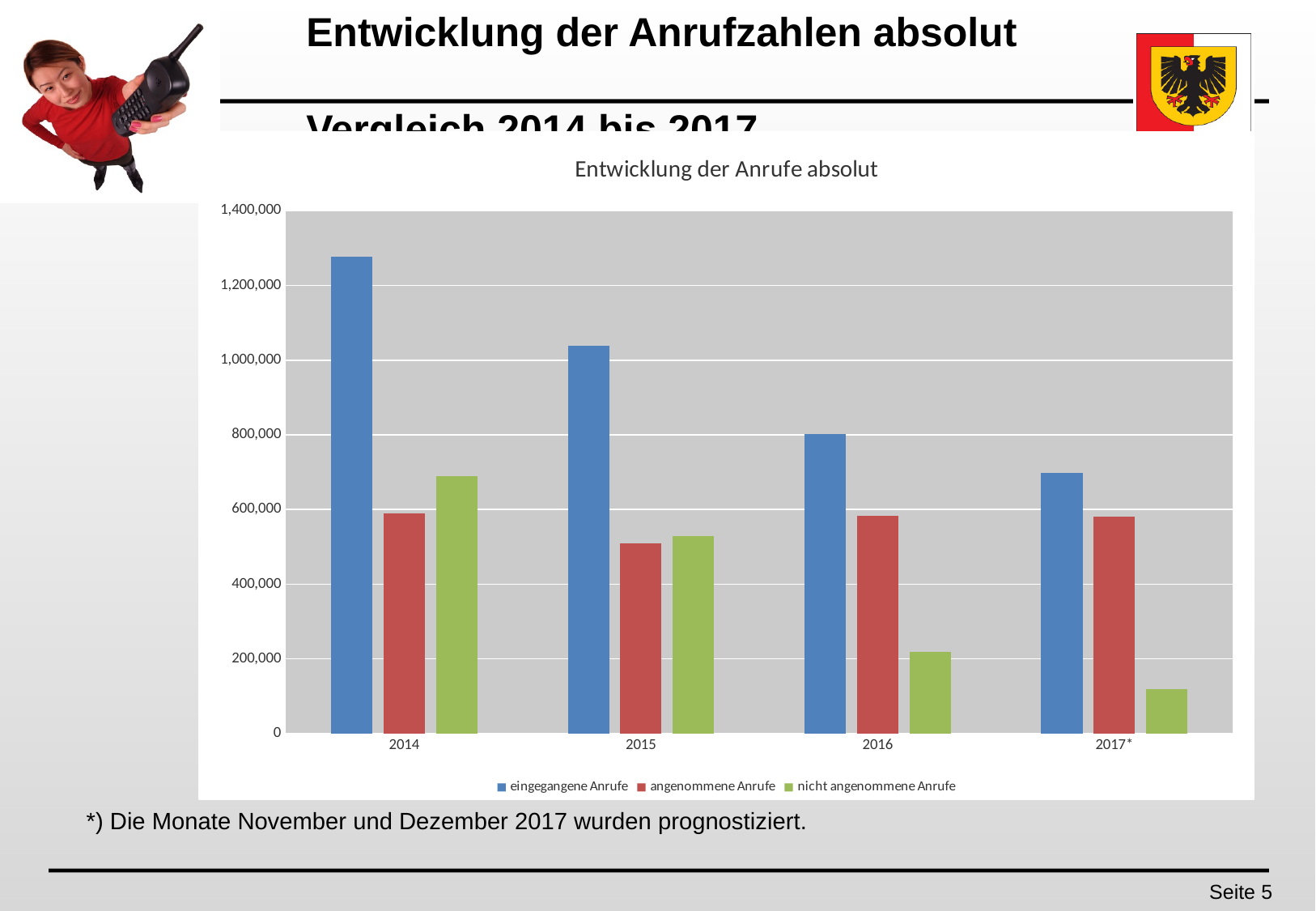
Is the value for angenommene Anrufe in 2015 greater or less than 600,000? less In which year is the value for nicht angenommene Anrufe lowest? 2017* How many series does the legend list? 3 How many years are shown on the x axis? 4 In 2014, which is larger: angenommene Anrufe or nicht angenommene Anrufe? nicht angenommene Anrufe What is the title of the chart? Entwicklung der Anrufe absolut In 2017*, which is larger: angenommene Anrufe or nicht angenommene Anrufe? angenommene Anrufe In which year is the value for eingegangene Anrufe highest? 2014 What kind of chart is shown on the slide? bar chart Do the values for eingegangene Anrufe rise or fall from 2014 to 2017*? fall Is the value for eingegangene Anrufe in 2014 greater or less than 1,200,000? greater Is the value for nicht angenommene Anrufe in 2016 greater or less than 400,000? less